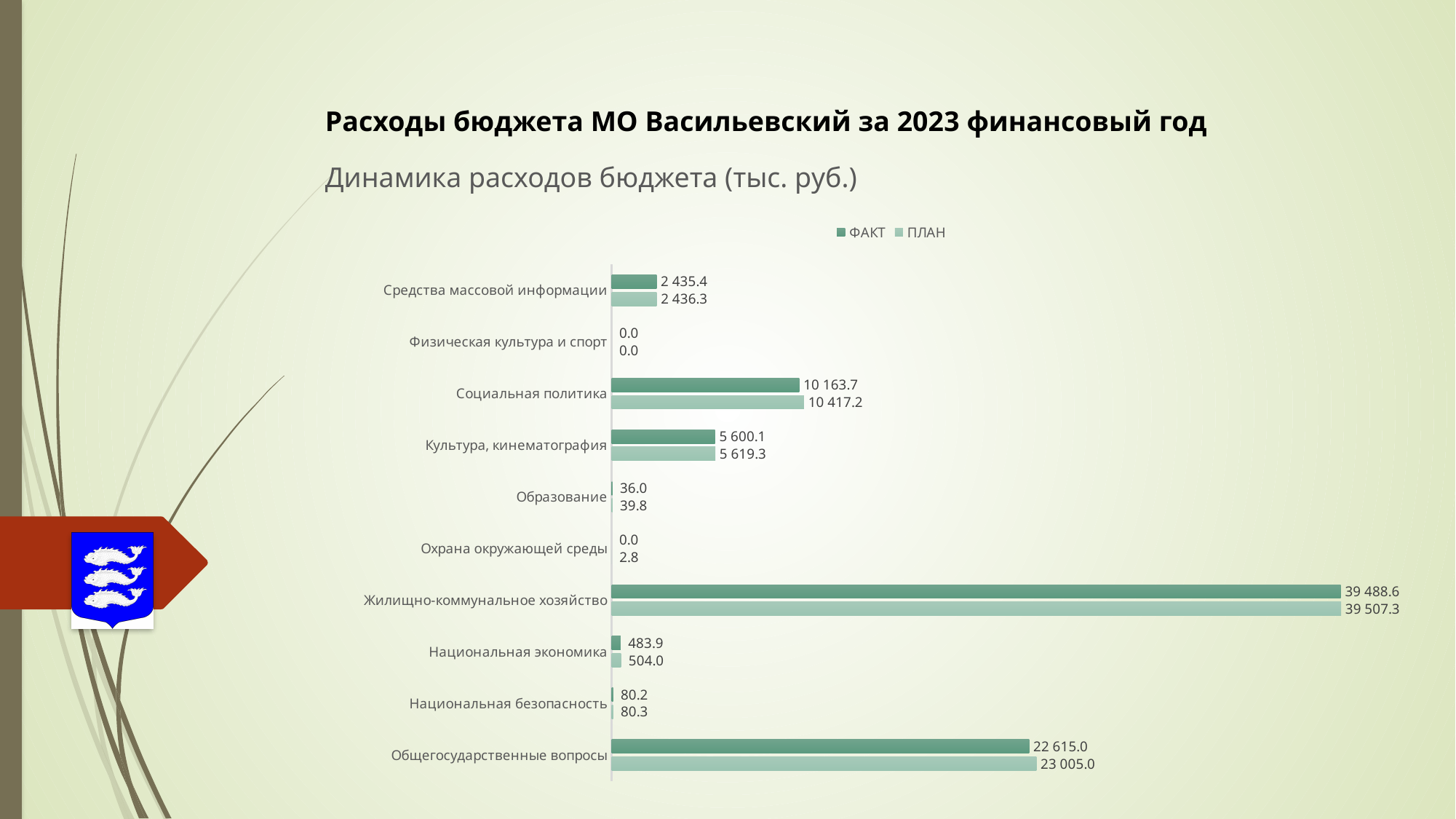
What is the ПЛАН value for Социальная политика? 10 417.2 What type of chart is shown on the slide? bar chart What is the ПЛАН value for Охрана окружающей среды? 2.8 What is the ФАКТ value for Национальная экономика? 483.9 How many categories are shown on the chart? 10 What is the difference between the ПЛАН and ФАКТ values for Общегосударственные вопросы? 390.0 Which is larger: the ФАКТ value for Социальная политика or the ФАКТ value for Культура, кинематография? Социальная политика What is the subtitle of the chart? Динамика расходов бюджета (тыс. руб.) Which category has the highest ФАКТ value? Жилищно-коммунальное хозяйство How many series does the legend list? 2 Which category has the lowest ПЛАН value? Физическая культура и спорт What is the ФАКТ value for Жилищно-коммунальное хозяйство? 39 488.6